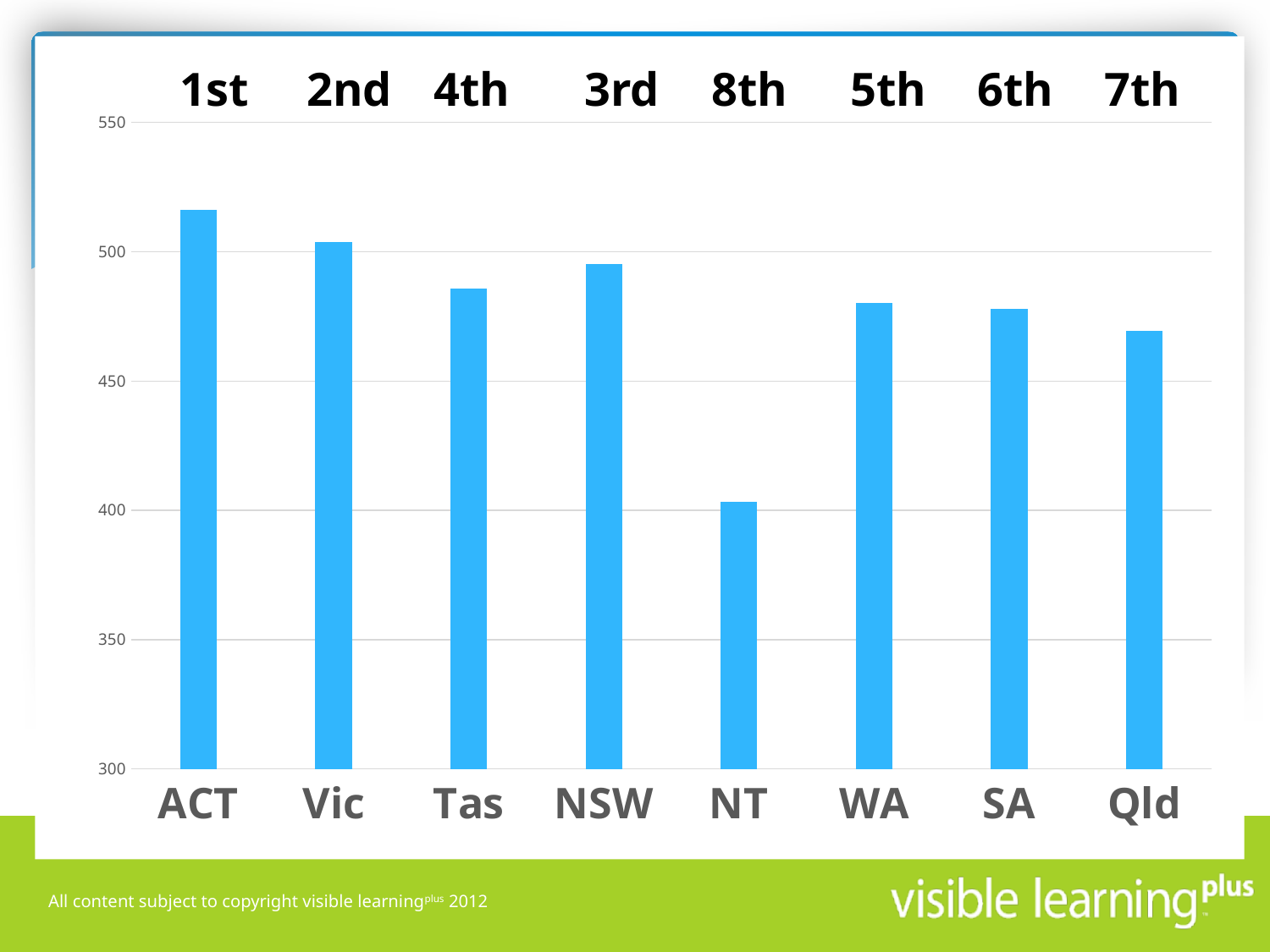
Which category has the highest bar? ACT Is the value for ACT greater or less than 500? greater What ranking label is printed above the NSW bar? 3rd How many categories (bars) are shown in the chart? 8 Is the value for Tas greater or less than 450? greater Which is larger, the value for NSW or the value for Tas? NSW Which is larger, the value for NT or the value for WA? WA Is the value for NT greater or less than 450? less Which category has the lowest bar? NT What ranking label is printed above the NT bar? 8th What kind of chart is shown on the slide? bar chart